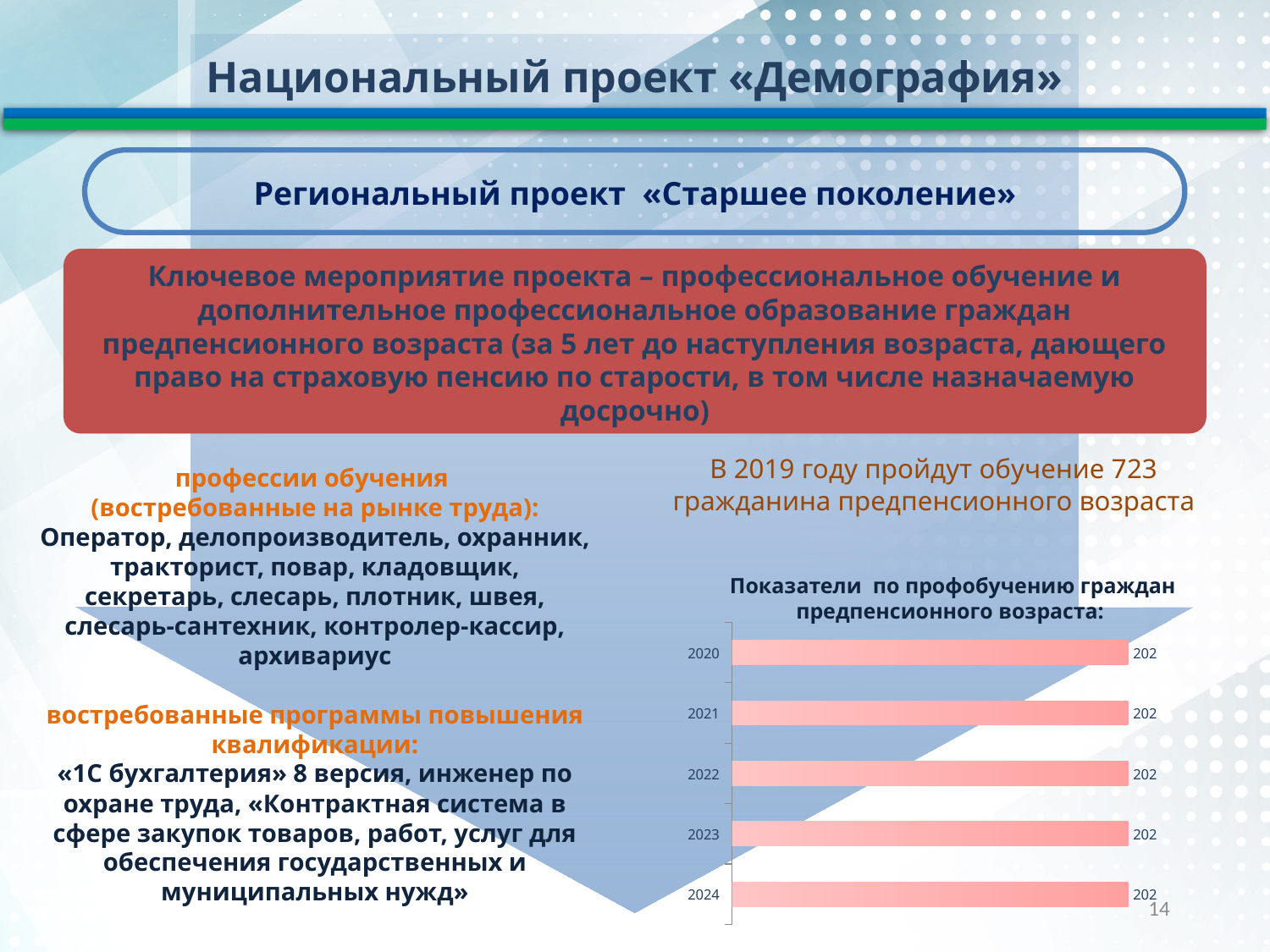
What is the value for 2024 in the chart? 202 Do the values rise, fall, or stay the same from 2020 to 2024? stay the same What is the title of the chart? Показатели по профобучению граждан предпенсионного возраста: What is the value for 2021 in the chart? 202 What is the value for 2020 in the chart? 202 How many categories (years) are shown in the chart? 5 What is the difference between the values for 2023 and 2020? 0 What is the value for 2022 in the chart? 202 Which year is the first (top) category in the chart? 2020 What kind of chart is shown on the slide? bar chart What colour are the bars in the chart? pink